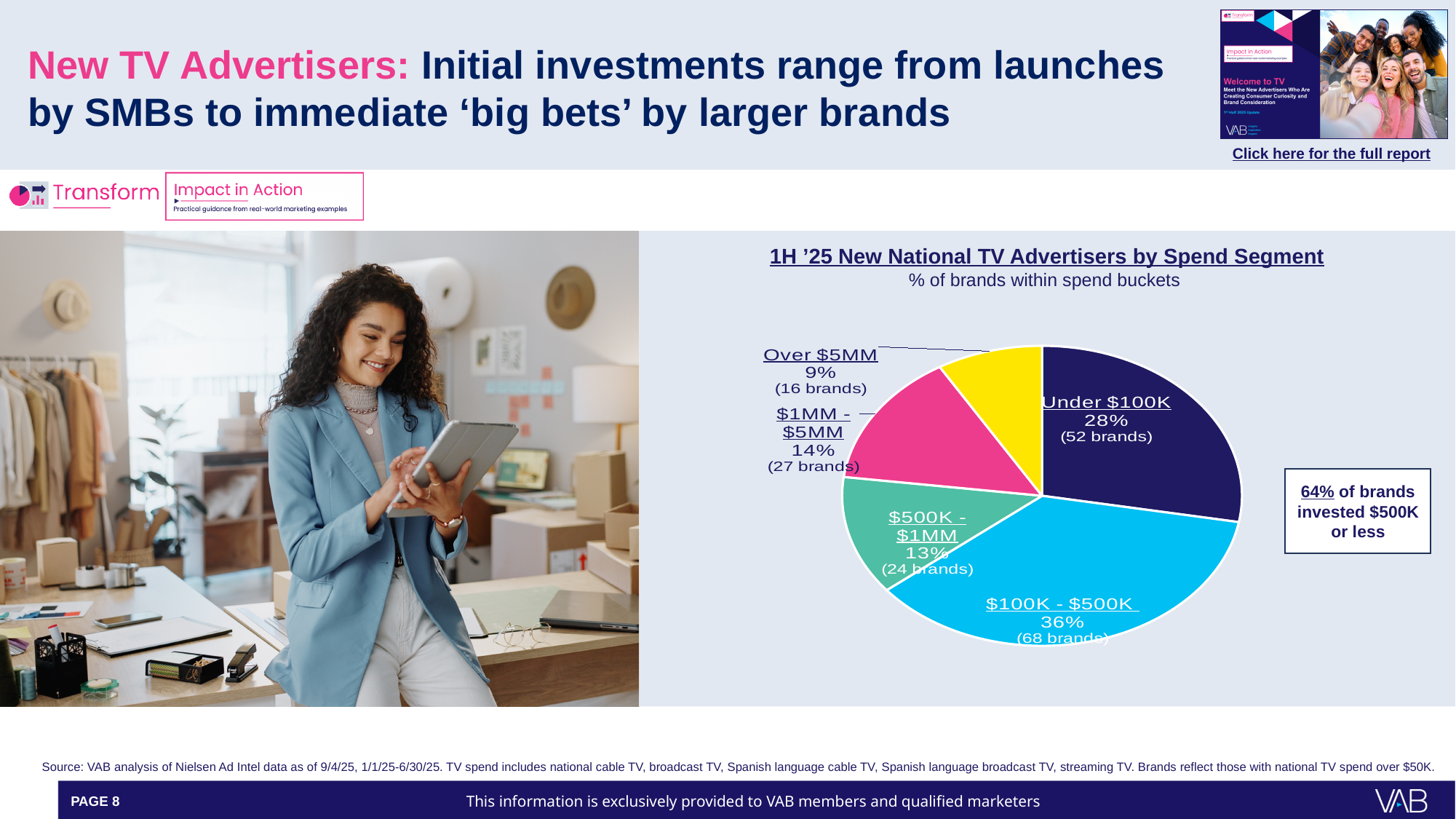
What is the title of the chart on the slide? 1H '25 New National TV Advertisers by Spend Segment Which has a larger share of brands: the $1MM - $5MM segment or the $500K - $1MM segment? $1MM - $5MM What is the difference in percentage points between the $100K - $500K segment and the Under $100K segment? 8 percentage points What percentage of brands are in the Over $5MM spend segment? 9% How many brands are in the $1MM - $5MM spend segment? 27 brands Which spend segment has the largest share of brands? $100K - $500K How many more brands are in the $500K - $1MM segment than in the Over $5MM segment? 8 brands What percentage of brands fall in the $100K - $500K spend segment? 36% How many brands are in the Under $100K spend segment? 52 brands What type of chart is used to show new national TV advertisers by spend segment? Pie chart Which spend segment has the smallest share of brands? Over $5MM How many spend segments are shown in the pie chart? 5